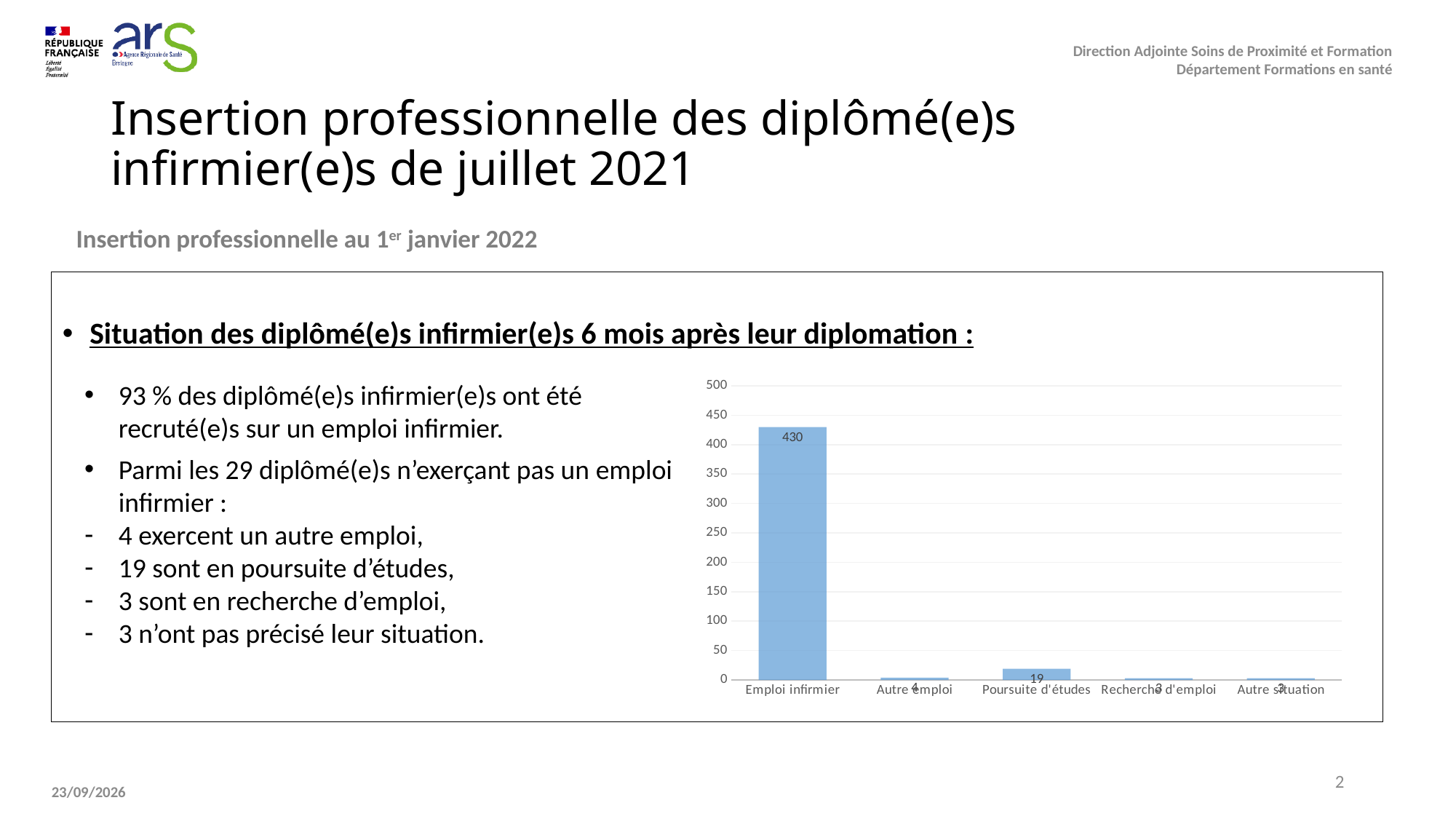
How many categories are shown on the x axis of the chart? 5 What is the highest tick value shown on the chart's vertical axis? 500 What is the value for Poursuite d'études in the chart? 19 What is the value for Recherche d'emploi in the chart? 3 What is the value for Autre emploi in the chart? 4 What kind of chart is shown on the slide? bar chart Is the value for Emploi infirmier greater or less than 400? greater Which is larger, the value for Poursuite d'études or the value for Autre emploi? Poursuite d'études What is the value for Emploi infirmier in the chart? 430 Which category has the highest value in the chart? Emploi infirmier What is the total of all the bars in the chart? 459 What is the difference between the values for Emploi infirmier and Poursuite d'études? 411